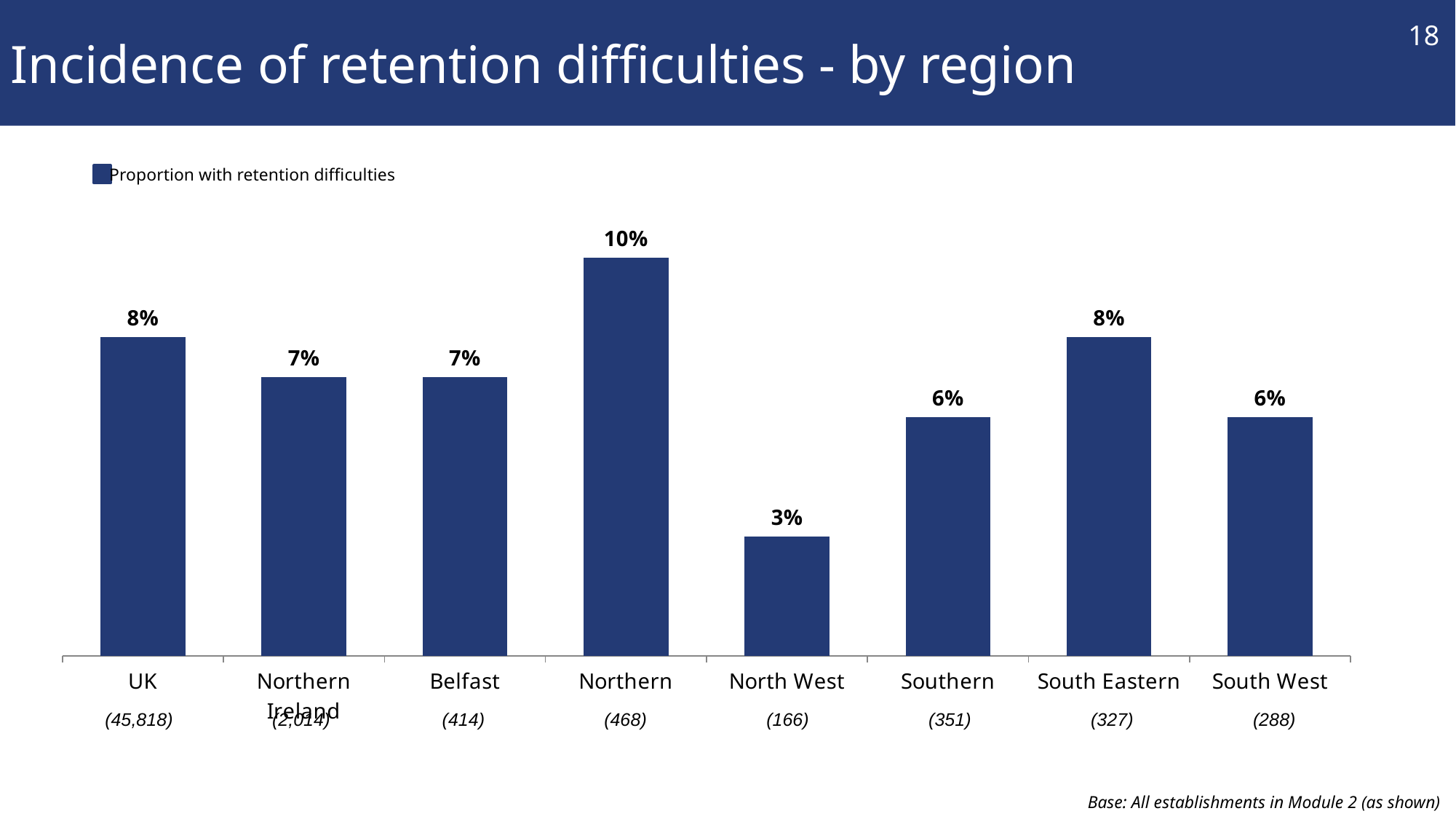
Which has a higher proportion with retention difficulties, South Eastern or Southern? South Eastern What kind of chart is shown on the slide? Bar chart What is the difference between the proportion with retention difficulties for Northern and for North West? 7% How many regions are shown on the chart? 8 What is the proportion with retention difficulties for the UK? 8% What is the title of the chart? Incidence of retention difficulties - by region What is the proportion with retention difficulties for Northern? 10% What is the proportion with retention difficulties for Belfast? 7% Which region has the highest proportion with retention difficulties? Northern How many series does the legend list? 1 What is the proportion with retention difficulties for North West? 3% Which region has the lowest proportion with retention difficulties? North West